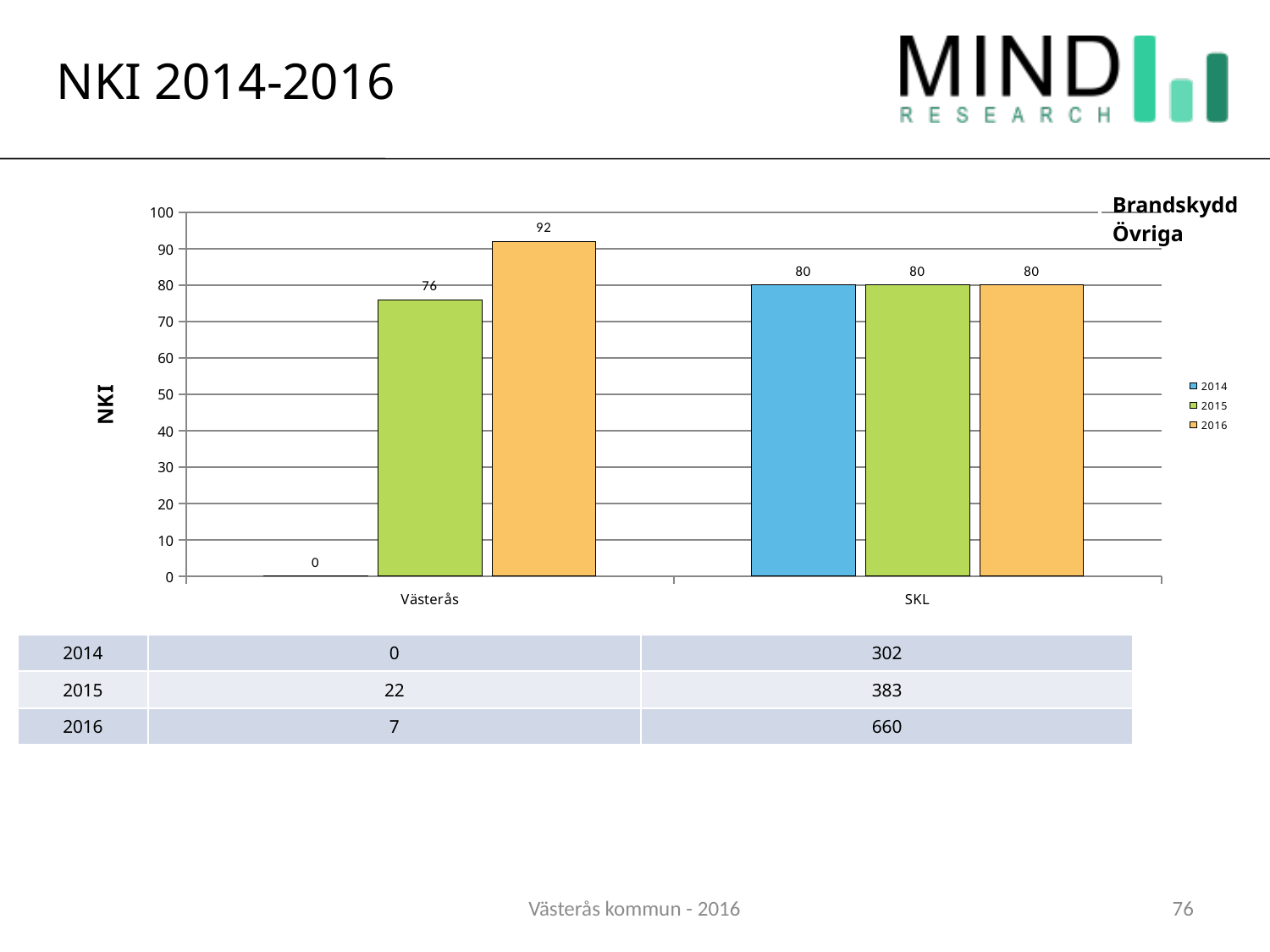
Which is larger, the 2016 NKI value for Västerås or the 2016 NKI value for SKL? Västerås What is the NKI value for SKL in 2014? 80 Which year has the highest NKI value for Västerås? 2016 What is the NKI value for Västerås in 2015? 76 What kind of chart is shown on the slide? Bar chart How many series does the legend list? 3 How many categories are shown on the x axis? 2 Which year has the lowest NKI value for Västerås? 2014 What is the label of the y axis? NKI What is the NKI value for Västerås in 2014? 0 What is the NKI value for Västerås in 2016? 92 What is the difference between the Västerås NKI values for 2016 and 2015? 16